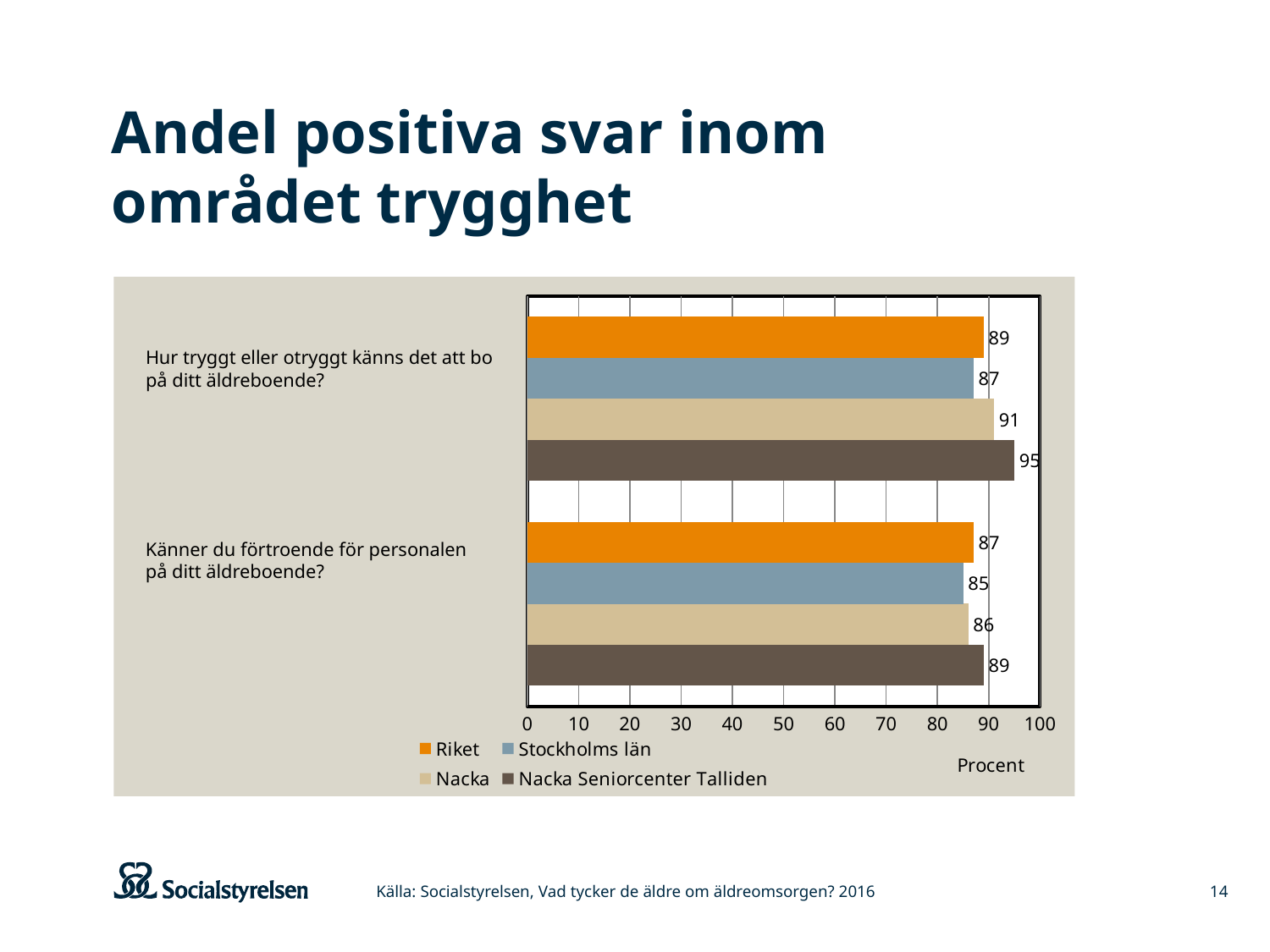
Which is larger for Nacka: the value for "Hur tryggt eller otryggt känns det att bo på ditt äldreboende?" or for "Känner du förtroende för personalen på ditt äldreboende?"? Hur tryggt eller otryggt känns det att bo på ditt äldreboende? What is the label on the horizontal axis of the chart? Procent How many series does the legend list? 4 What is the difference between Nacka and Stockholms län for the question "Känner du förtroende för personalen på ditt äldreboende?"? 1 What kind of chart is shown on the slide? Bar chart What is the difference between Nacka Seniorcenter Talliden and Riket for the question "Hur tryggt eller otryggt känns det att bo på ditt äldreboende?"? 6 Which series has the highest value for the question "Hur tryggt eller otryggt känns det att bo på ditt äldreboende?"? Nacka Seniorcenter Talliden What is the value for Stockholms län for the question "Känner du förtroende för personalen på ditt äldreboende?"? 85 What is the value for Riket for the question "Hur tryggt eller otryggt känns det att bo på ditt äldreboende?"? 89 What is the value for Nacka Seniorcenter Talliden for the question "Hur tryggt eller otryggt känns det att bo på ditt äldreboende?"? 95 Which series has the lowest value for the question "Känner du förtroende för personalen på ditt äldreboende?"? Stockholms län Is the value for Riket for the question "Känner du förtroende för personalen på ditt äldreboende?" greater or less than 80? greater